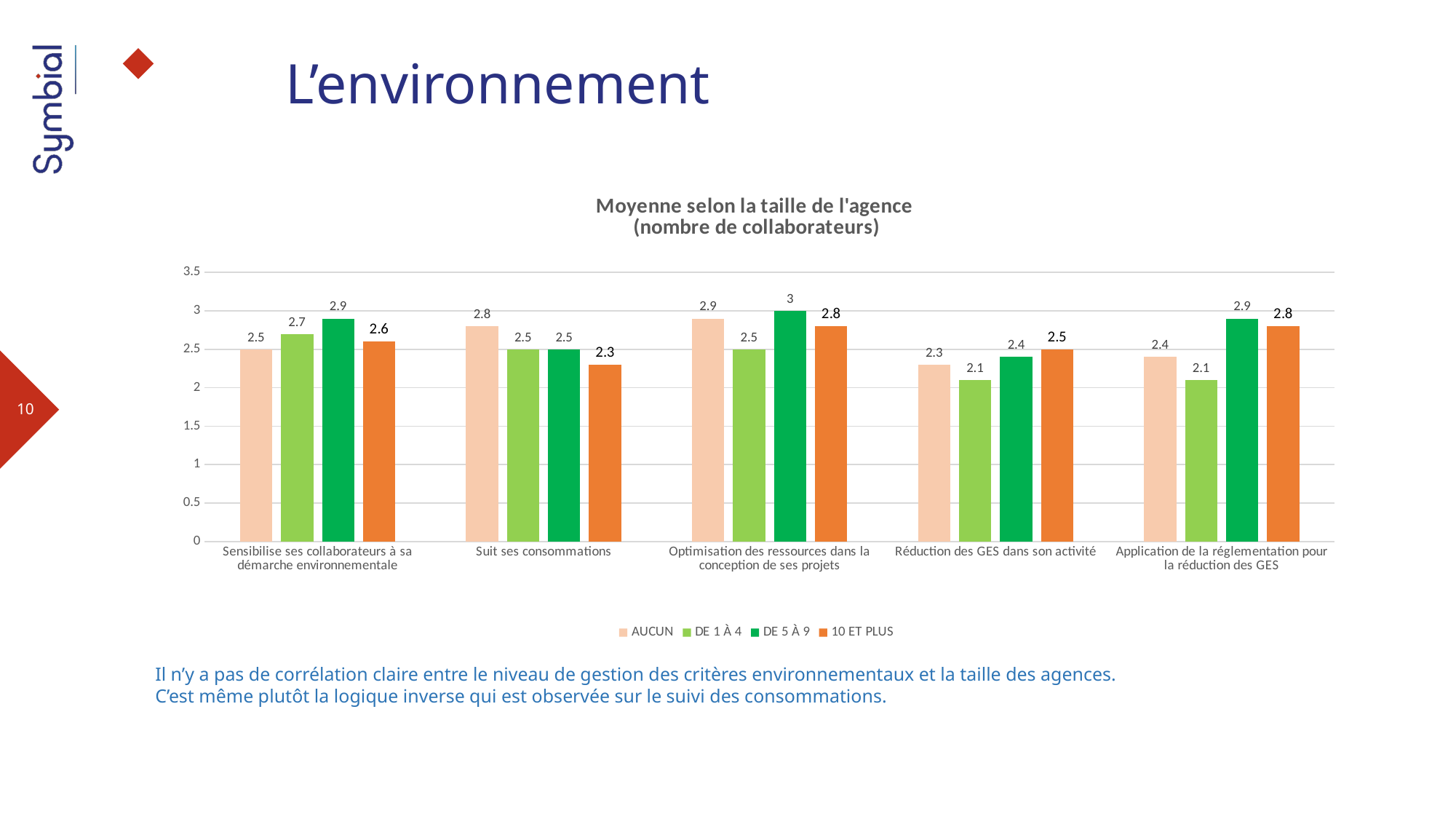
Which series has the highest value in the 'Application de la réglementation pour la réduction des GES' category? DE 5 À 9 What is the difference between the 'AUCUN' and '10 ET PLUS' values in the 'Suit ses consommations' category? 0.5 What is the value for 'DE 5 À 9' in the 'Optimisation des ressources dans la conception de ses projets' category? 3 How many series does the legend list? 4 Which series has the lowest value in the 'Suit ses consommations' category? 10 ET PLUS What is the value for 'AUCUN' in the 'Suit ses consommations' category? 2.8 What is the value for '10 ET PLUS' in the 'Réduction des GES dans son activité' category? 2.5 Which is larger in the 'Sensibilise ses collaborateurs à sa démarche environnementale' category: 'DE 1 À 4' or '10 ET PLUS'? DE 1 À 4 What is the difference between the 'DE 5 À 9' and 'DE 1 À 4' values in the 'Application de la réglementation pour la réduction des GES' category? 0.8 How many categories are shown on the x axis? 5 What kind of chart is shown on the slide? Bar chart What is the title of the chart? Moyenne selon la taille de l'agence (nombre de collaborateurs)